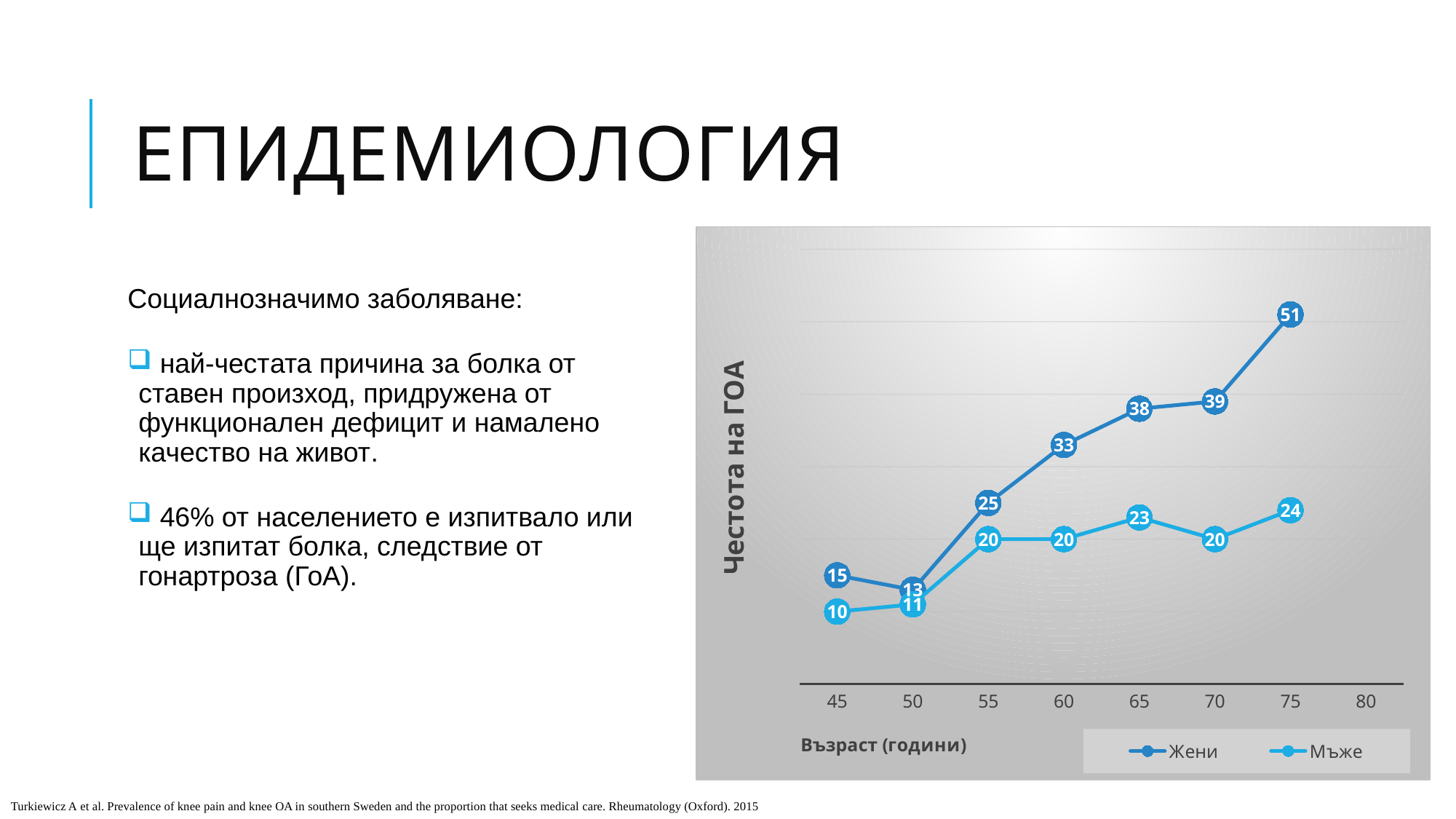
Which series has the larger value at age 70, Жени or Мъже? Жени What is the label of the x axis? Възраст (години) At which age is the value for Жени highest? 75 What is the value for Жени at age 60? 33 What is the value for Мъже at age 65? 23 At which age is the value for Мъже lowest? 45 Does the Жени series generally rise or fall as age increases from 50 to 75? rise What is the difference between the Жени and Мъже values at age 75? 27 What is the value for Жени at age 75? 51 How many series does the legend list? 2 What is the value for Мъже at age 45? 10 What kind of chart is shown on the slide? line chart